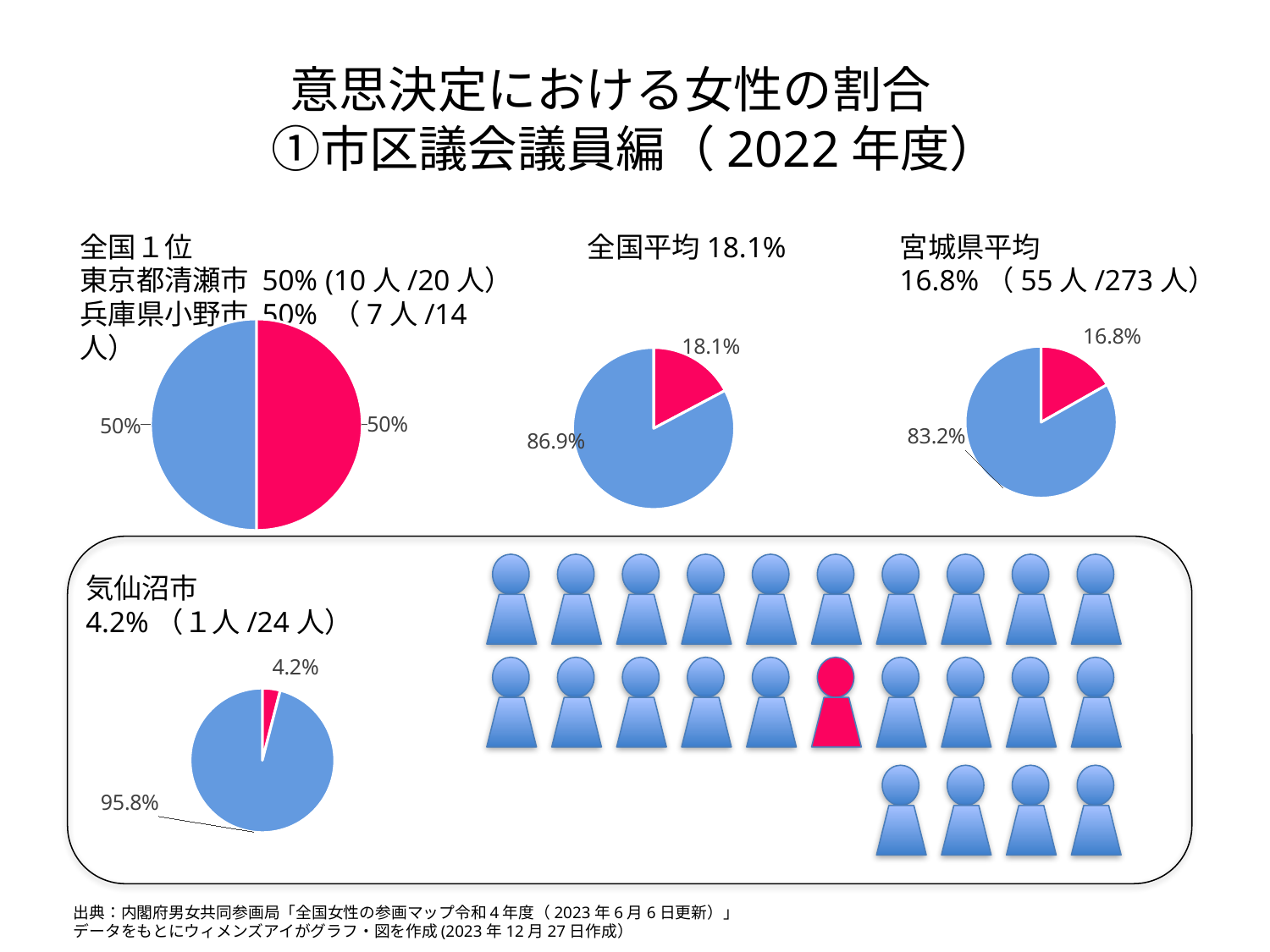
In the 宮城県平均 pie chart, what percentage is shown for the pink slice? 16.8% In the 宮城県平均 pie chart, what percentage is shown for the blue slice? 83.2% In the 気仙沼市 pie chart, what percentage is shown for the pink slice? 4.2% In the 全国平均 pie chart, what percentage is shown for the blue slice? 86.9% In the 全国1位 pie chart at the top left, what percentage is shown for each of the two slices? 50% Which pie chart has the smallest pink slice: 全国平均, 宮城県平均 or 気仙沼市? 気仙沼市 How many pie charts are shown on the slide? 4 In the 全国平均 pie chart, what percentage is shown for the pink (female) slice? 18.1% In the 気仙沼市 pie chart, what percentage is shown for the blue slice? 95.8% What kind of chart is used for 全国平均, 宮城県平均 and 気仙沼市? Pie chart Is the pink slice in the 全国平均 pie chart larger or smaller than the pink slice in the 宮城県平均 pie chart? Larger What is the difference between the pink slice of the 全国平均 pie chart (18.1%) and the pink slice of the 宮城県平均 pie chart (16.8%)? 1.3%